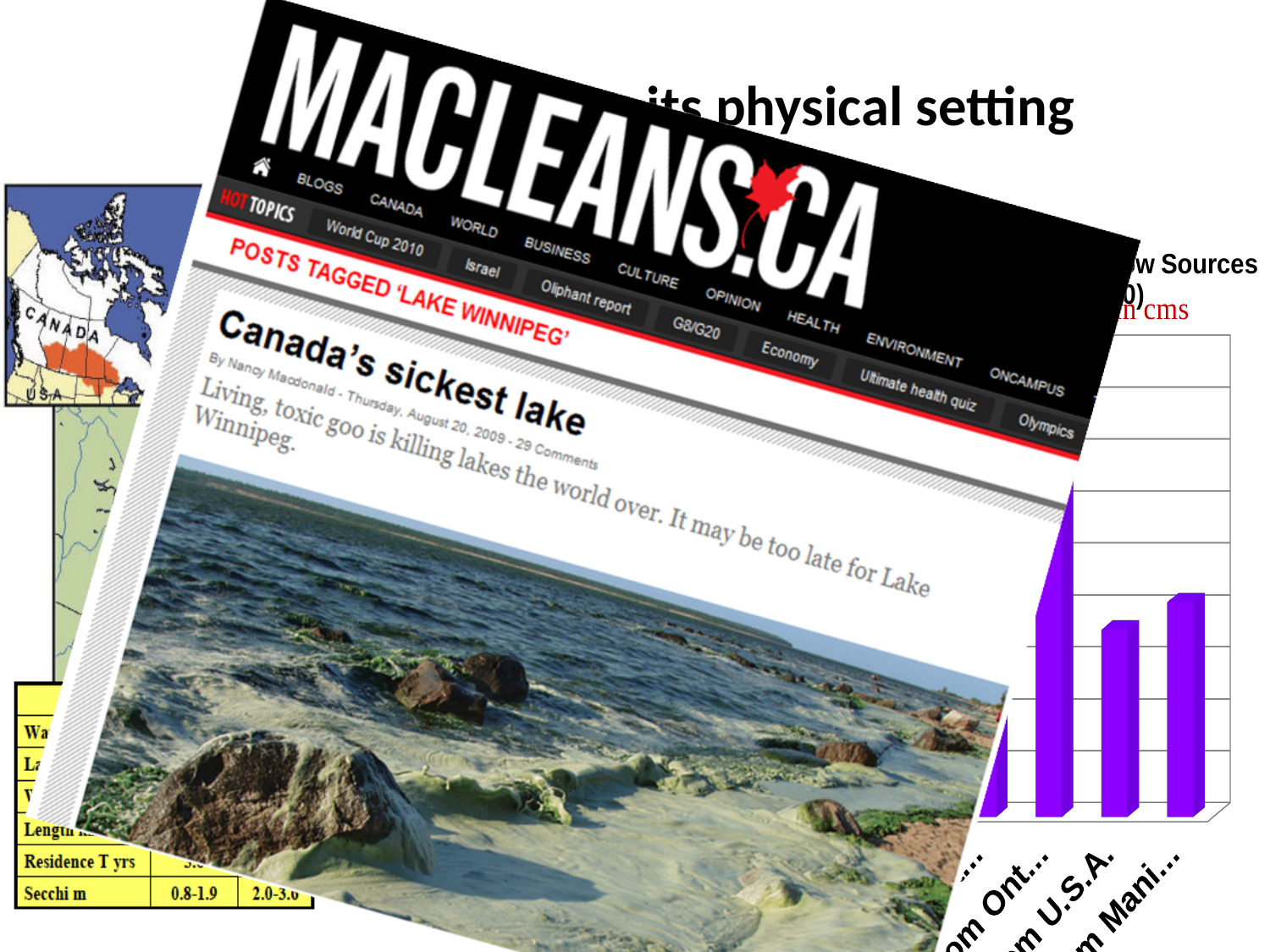
What colour are the bars in the chart on the right side of the slide? purple In the chart on the right side of the slide, which bar is taller: the one labelled '...m U.S.A.' or the one labelled '...m Mani...'? ...m Mani... What kind of chart is shown on the right side of the slide? bar chart